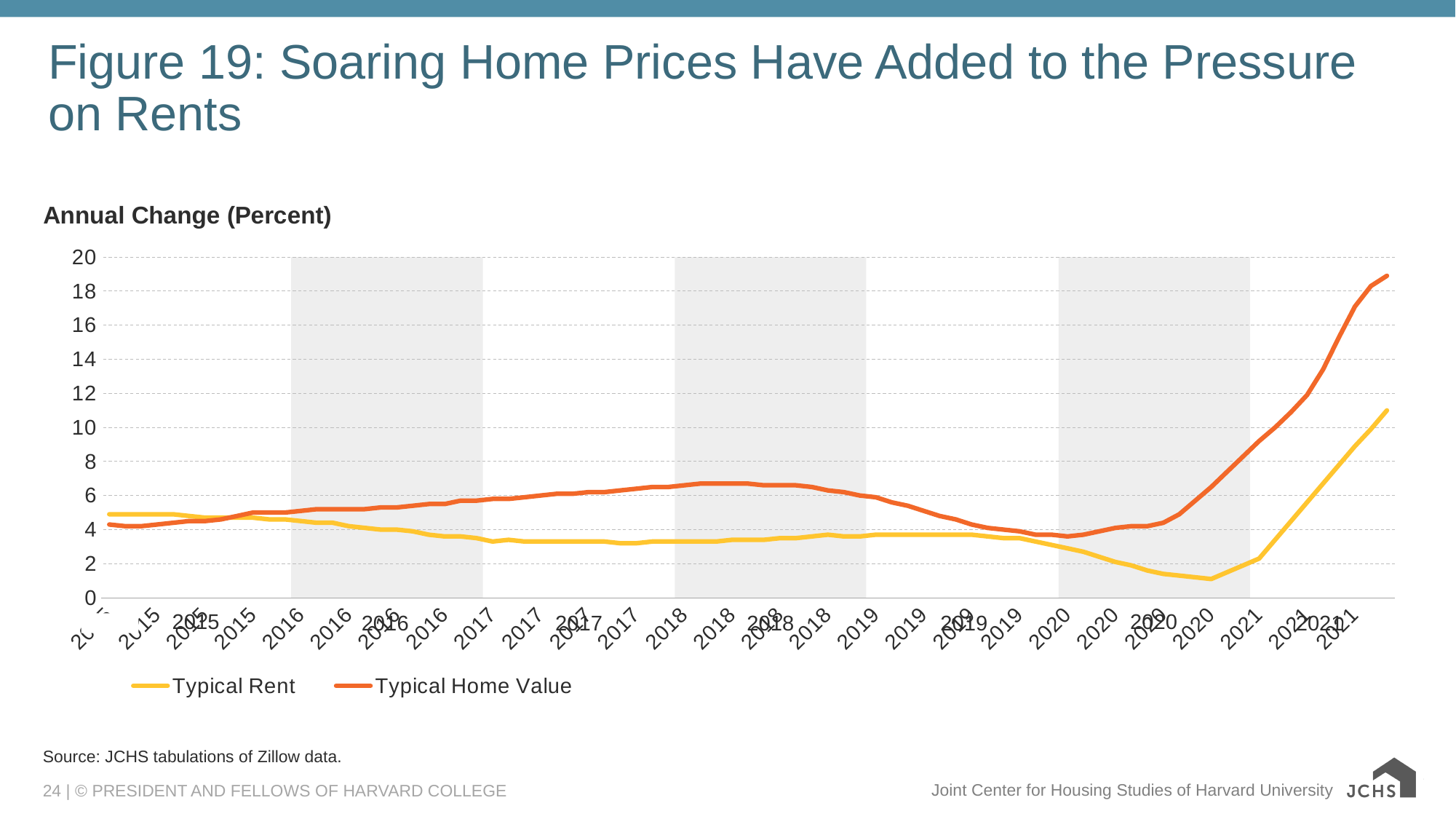
What is the label on the vertical axis of the chart? Annual Change (Percent) What kind of chart is shown on the slide? line chart Is the peak value for Typical Home Value during 2018 greater or less than 8? less How many series does the legend list? 2 At the right end of the chart (late 2021), which series is higher, Typical Rent or Typical Home Value? Typical Home Value Do both series rise or fall from 2020 to the end of 2021? rise Is the lowest value for Typical Rent, reached in late 2020, greater or less than 2? less Is the value for Typical Home Value at the right end of the chart (late 2021) greater or less than 16? greater Which series reaches the highest value anywhere on the chart? Typical Home Value What are the two series named in the legend? Typical Rent and Typical Home Value Which series drops to the lowest value anywhere on the chart? Typical Rent